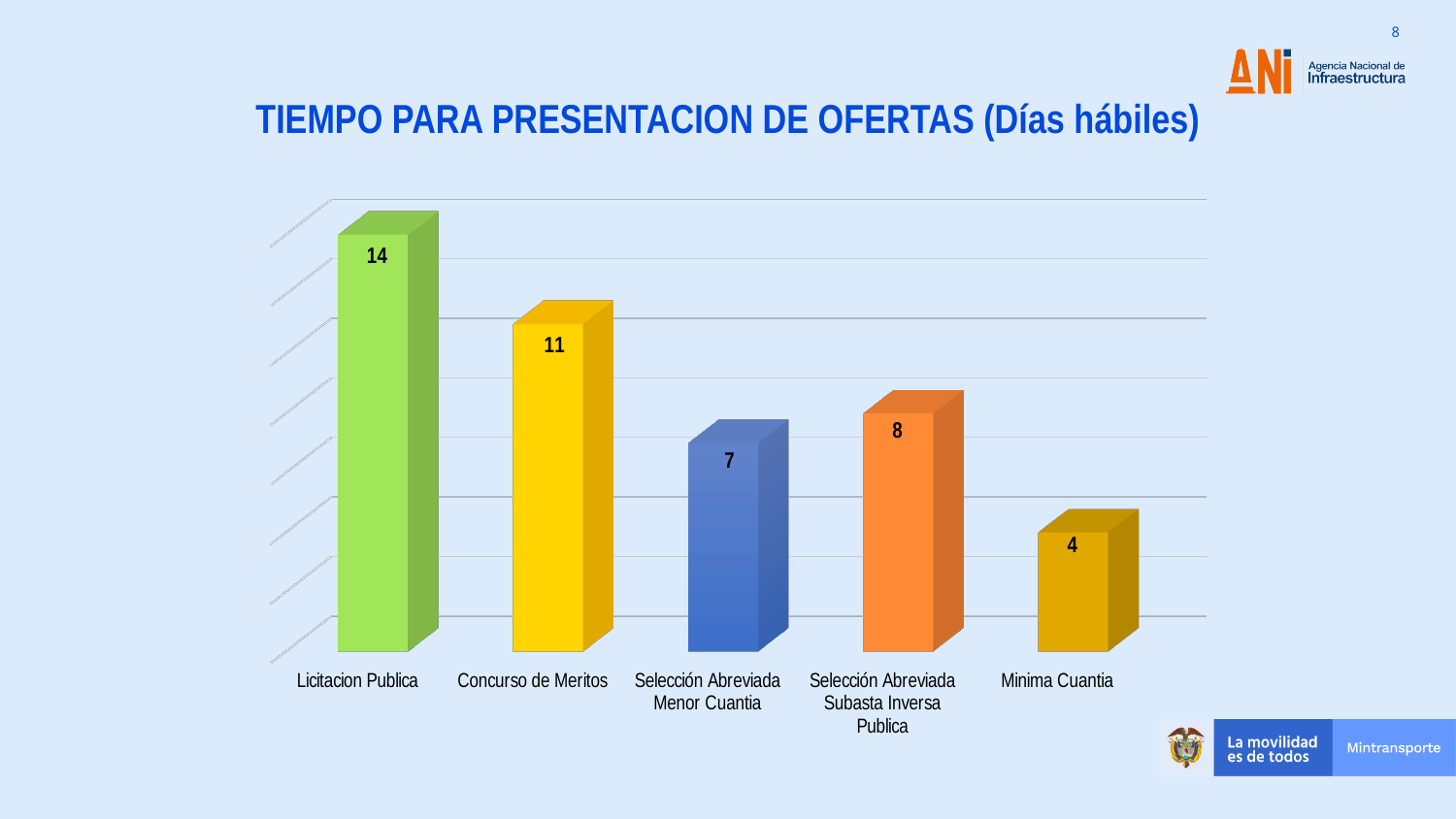
Which category has the highest value? Licitacion Publica What is the difference between the values for Concurso de Meritos and Selección Abreviada Subasta Inversa Publica? 3 What is the value for Selección Abreviada Subasta Inversa Publica? 8 What is the value for Concurso de Meritos? 11 Which category has the lowest value? Minima Cuantia What is the value for Minima Cuantia? 4 What is the difference between the values for Licitacion Publica and Minima Cuantia? 10 Which is larger, the value for Selección Abreviada Menor Cuantia or the value for Selección Abreviada Subasta Inversa Publica? Selección Abreviada Subasta Inversa Publica What is the value for Licitacion Publica? 14 How many categories are shown in the chart? 5 What is the value for Selección Abreviada Menor Cuantia? 7 What kind of chart is shown on the slide? Bar chart